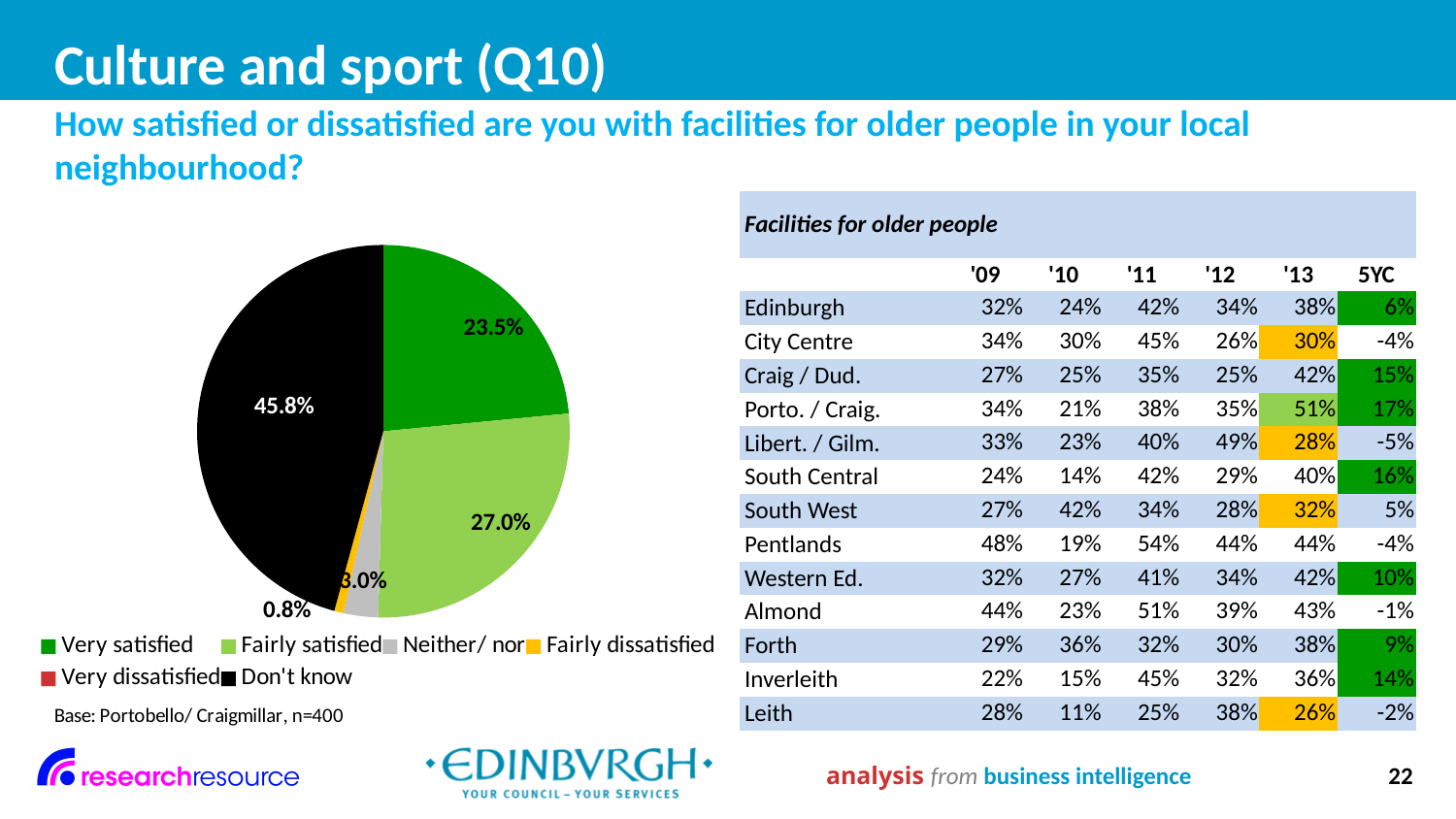
What is the difference in percentage points between 'Don't know' and 'Very satisfied' in the pie chart? 22.3 What is the difference in percentage points between 'Fairly satisfied' and 'Very satisfied' in the pie chart? 3.5 Which response category has the largest slice of the pie chart? Don't know What percentage of respondents are 'Fairly satisfied' according to the pie chart? 27.0% What percentage of respondents are 'Very satisfied' according to the pie chart? 23.5% How many response categories does the pie chart legend list? 6 What kind of chart is shown on the slide? Pie chart Which is larger in the pie chart: 'Very satisfied' or 'Fairly satisfied'? Fairly satisfied What is the base (sample size) stated for the pie chart? Portobello/ Craigmillar, n=400 What colour is the 'Don't know' slice in the pie chart? Black What percentage of respondents are 'Fairly dissatisfied' according to the pie chart? 0.8% What percentage of respondents answered 'Don't know' according to the pie chart? 45.8%